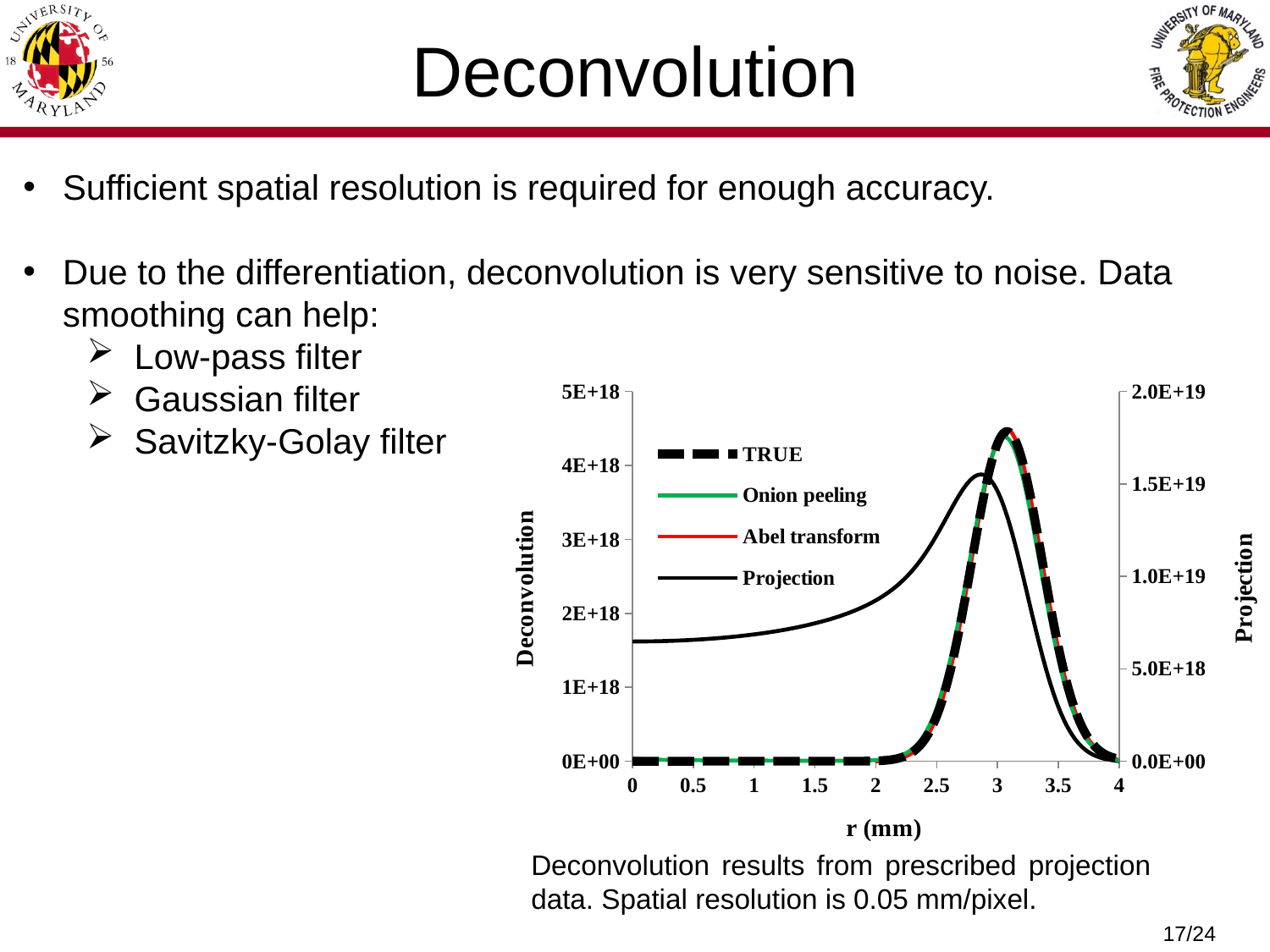
Is the value of the Projection series at r = 4 mm greater or less than 5.0E+18 on the Projection axis? less What is the title of the right-hand vertical axis of the chart? Projection What kind of chart is shown on the slide? Line chart What is the highest tick value shown on the left Deconvolution axis? 5E+18 Is the value of the Onion peeling series at r = 2 mm greater or less than 1E+18 on the Deconvolution axis? less How many series does the chart's legend list? 4 Does the Projection series rise or fall between r = 0 mm and r = 2.5 mm? rise What is the label of the x axis of the chart? r (mm) Is the peak value of the TRUE series greater or less than 4E+18 on the Deconvolution axis? greater Does the Abel transform series rise or fall between r = 3.5 mm and r = 4 mm? fall